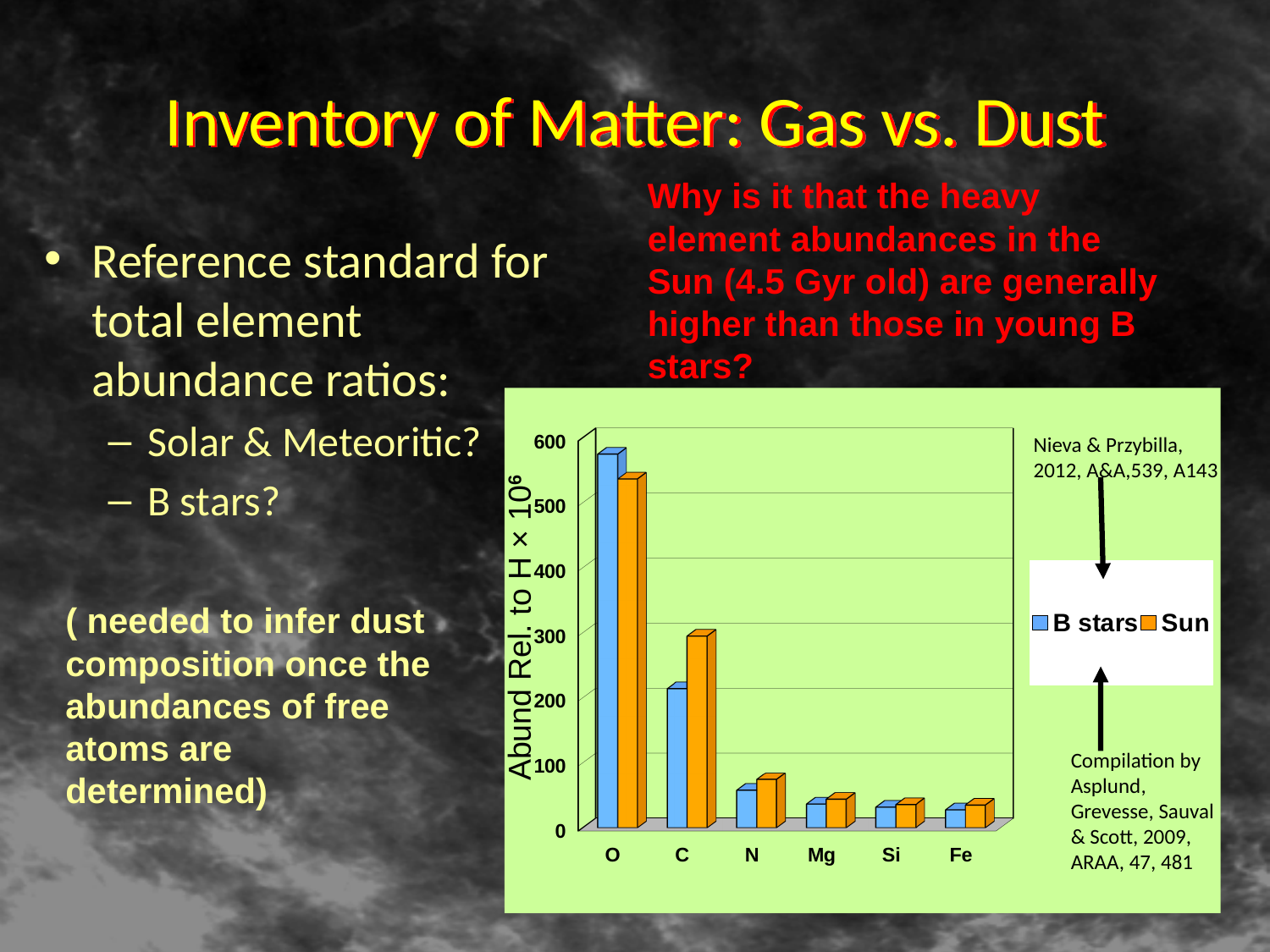
Which element has the highest abundance for the Sun series? O For C, which series has the larger value, B stars or Sun? Sun How many elements are shown along the x axis of the chart? 6 What kind of chart is shown on the slide? bar chart Which element has the highest abundance for the B stars series? O Is the Sun value for C greater or less than 200? greater Is the Sun value for N greater or less than 100? less How many series does the chart's legend list? 2 For O, which series has the larger value, B stars or Sun? B stars What is the label on the chart's vertical axis? Abund Rel. to H × 10^6 Is the B stars value for O greater or less than 500? greater Which two series are listed in the chart's legend? B stars and Sun